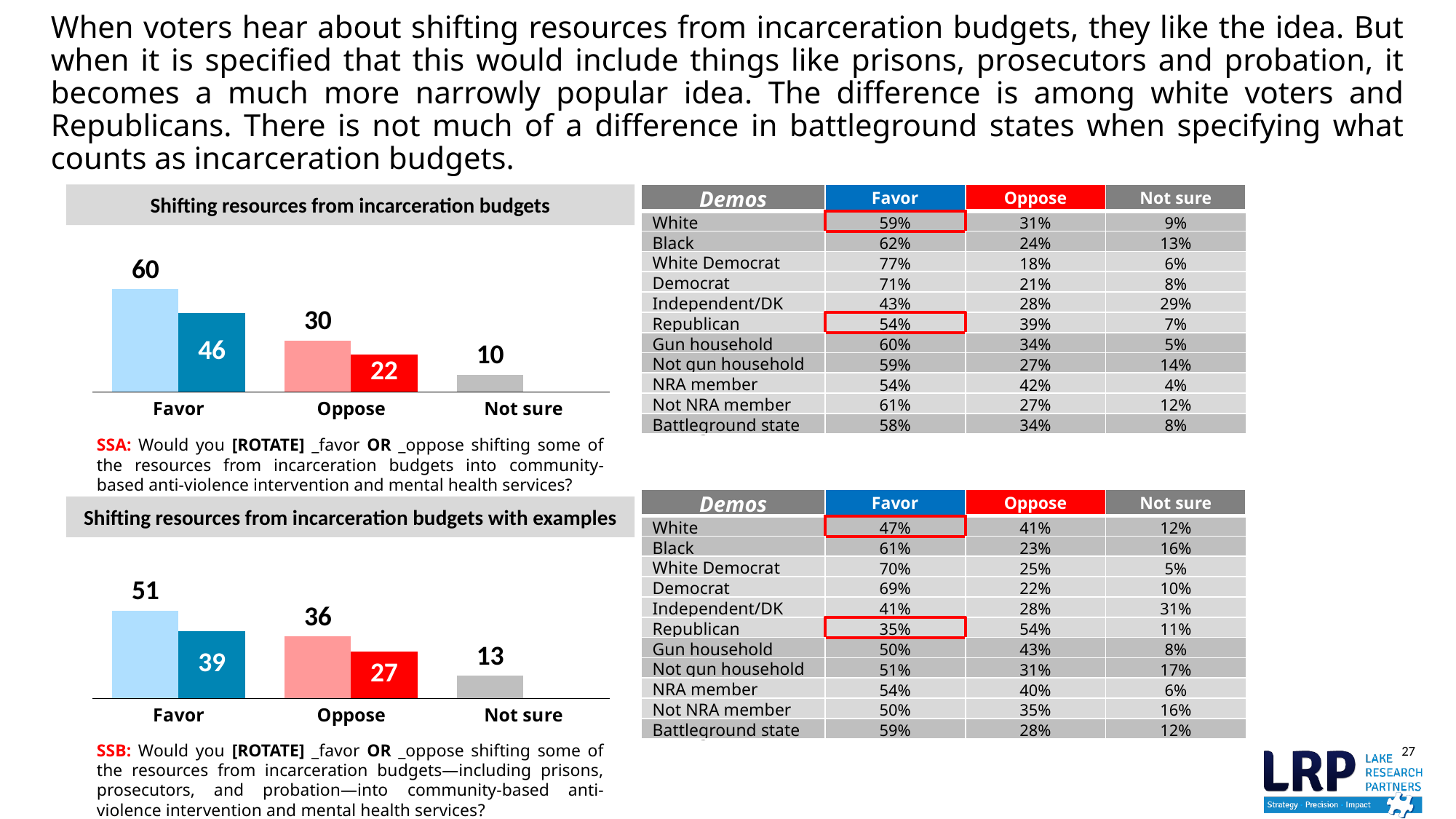
In the chart titled "Shifting resources from incarceration budgets with examples", what is the value labeled above the Favor bars? 51 In the chart titled "Shifting resources from incarceration budgets with examples", what is the value shown inside the darker Favor bar? 39 In the chart titled "Shifting resources from incarceration budgets with examples", what is the value for Not sure? 13 What type of chart is the chart titled "Shifting resources from incarceration budgets"? Bar chart In the chart titled "Shifting resources from incarceration budgets", what is the value labeled above the Favor bars? 60 In the chart titled "Shifting resources from incarceration budgets with examples", which category has the lowest value? Not sure In the chart titled "Shifting resources from incarceration budgets", what is the value shown inside the darker Oppose bar? 22 In the chart titled "Shifting resources from incarceration budgets", which category has the highest value? Favor In the chart titled "Shifting resources from incarceration budgets", what is the difference between the Favor total (60) and the Oppose total (30)? 30 In the chart titled "Shifting resources from incarceration budgets with examples", what is the difference between the Favor total (51) and the Oppose total (36)? 15 How many categories are shown on the x axis of the chart titled "Shifting resources from incarceration budgets with examples"? 3 In the chart titled "Shifting resources from incarceration budgets", what is the value for Not sure? 10